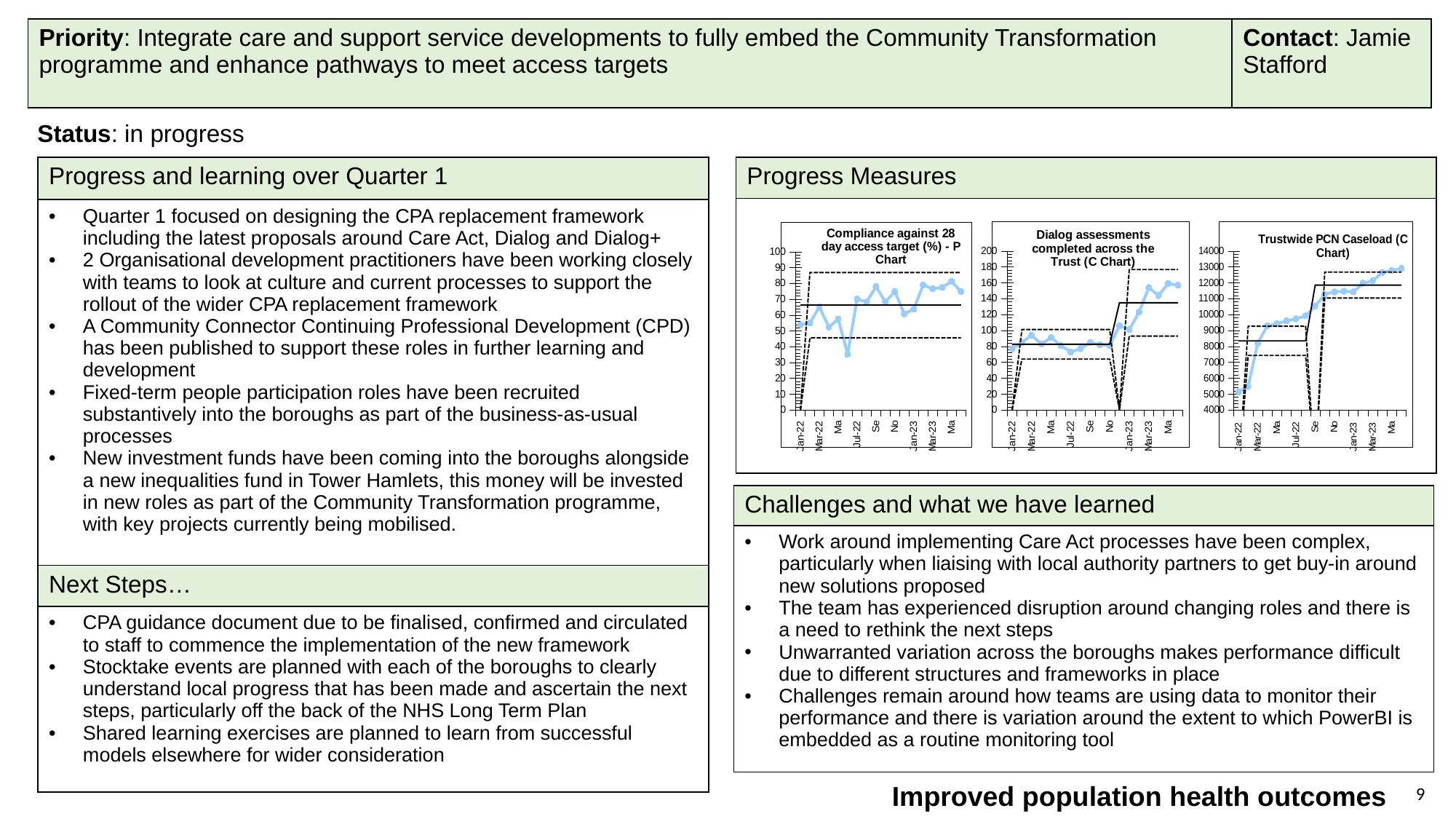
In the "Trustwide PCN Caseload (C Chart)", do the plotted values generally rise or fall from Jan-22 to the end of the series? rise How many charts are shown in the Progress Measures section? 3 In the "Dialog assessments completed across the Trust (C Chart)", is the value for Jan-22 greater or less than 120? less What kind of chart is the "Compliance against 28 day access target (%) - P Chart"? line chart What is the title of the middle chart in the Progress Measures section? Dialog assessments completed across the Trust (C Chart) In the "Trustwide PCN Caseload (C Chart)", is the value for Jan-22 greater or less than 8000? less What is the title of the rightmost chart in the Progress Measures section? Trustwide PCN Caseload (C Chart) In the "Trustwide PCN Caseload (C Chart)", is the last plotted value greater or less than 12000? greater What is the highest value shown on the y axis of the "Trustwide PCN Caseload (C Chart)"? 14000